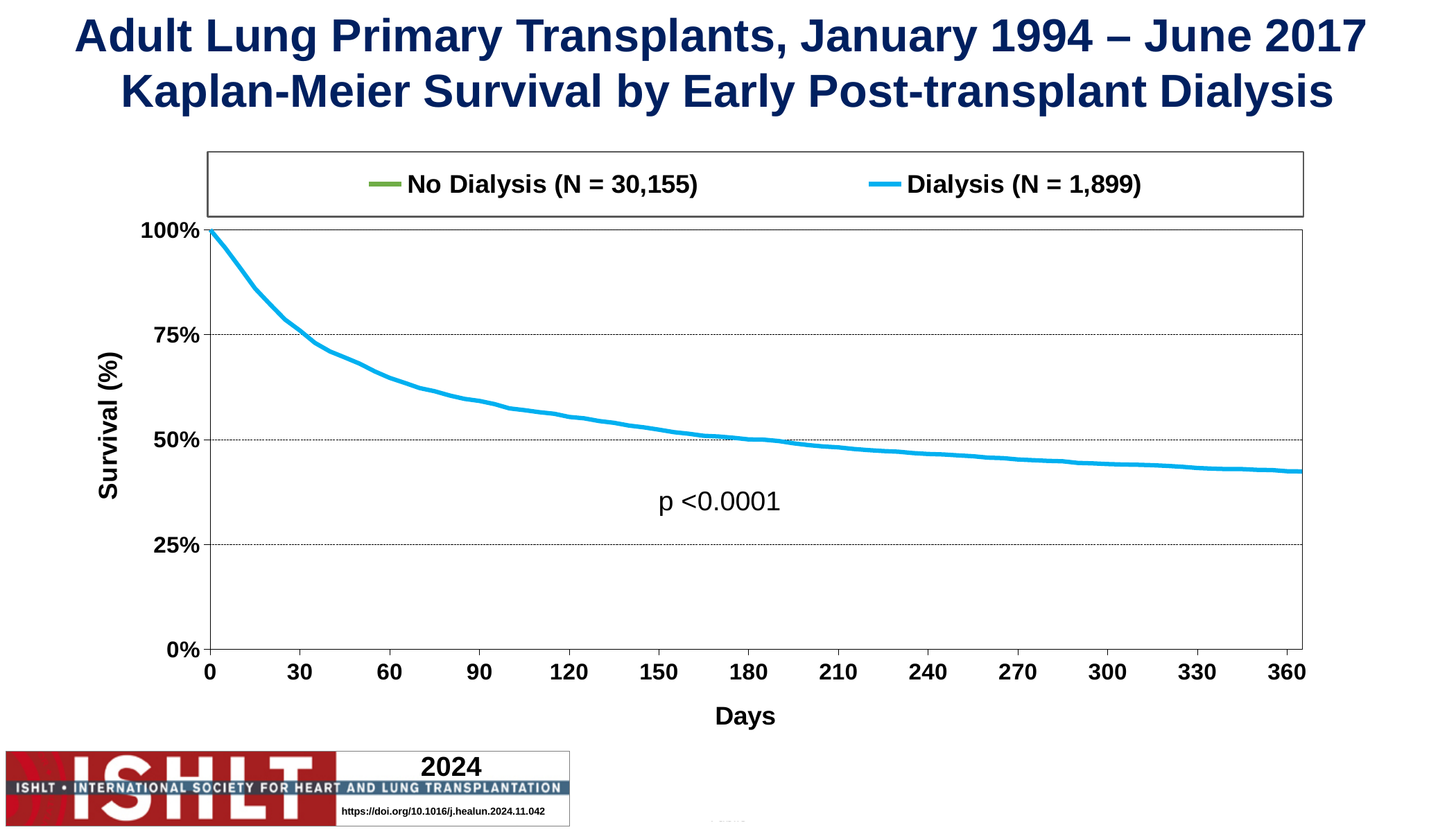
Is the Dialysis survival at 360 days greater or less than 50%? less Is the Dialysis survival at 60 days greater or less than 50%? greater Does the Dialysis survival curve rise or fall as days increase? Fall How many series does the legend list? 2 What kind of chart is shown on the slide? Line chart What is the largest tick value shown on the x axis? 360 What is the survival value of the Dialysis curve at day 0? 100% What is the N for the Dialysis group shown in the legend? 1,899 Is the Dialysis survival at 60 days greater or less than 75%? less What is the N for the No Dialysis group shown in the legend? 30,155 What is the label of the x axis? Days